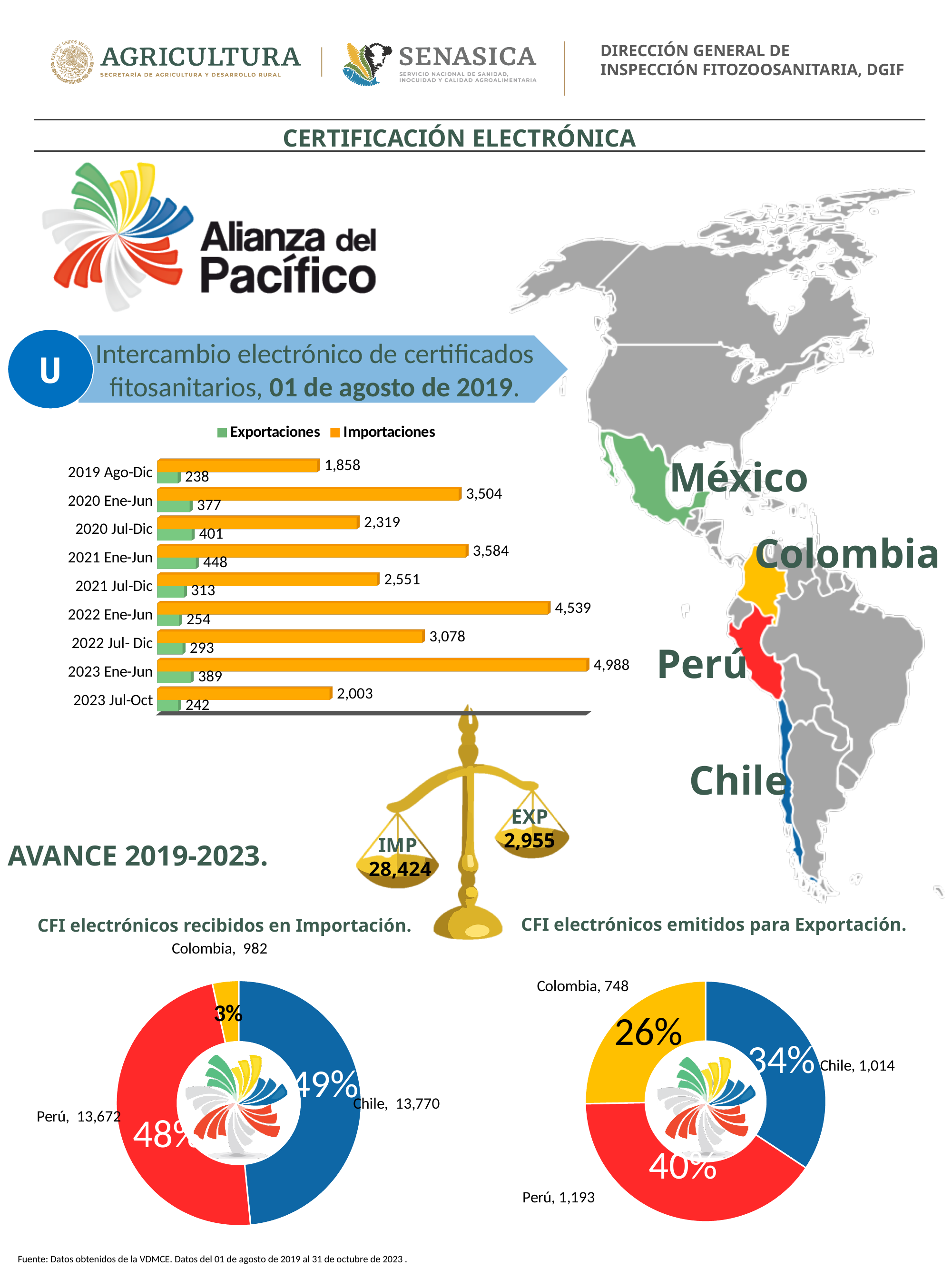
In the 'CFI electrónicos emitidos para Exportación' doughnut chart, which country has the largest share? Perú In the Exportaciones/Importaciones bar chart, which period has the highest Importaciones value? 2023 Ene-Jun In the 'CFI electrónicos recibidos en Importación' doughnut chart, what share does Colombia have? 3% In the 'CFI electrónicos emitidos para Exportación' doughnut chart, what is the value for Chile? 1,014 In the Exportaciones/Importaciones bar chart, what is the Importaciones value for 2022 Ene-Jun? 4,539 In the Exportaciones/Importaciones bar chart, what is the Exportaciones value for 2020 Jul-Dic? 401 How many periods are shown on the Exportaciones/Importaciones bar chart? 9 How many series does the legend of the Exportaciones/Importaciones bar chart list? 2 In the Exportaciones/Importaciones bar chart, what is the difference between Importaciones and Exportaciones for 2023 Ene-Jun? 4,599 In the Exportaciones/Importaciones bar chart, which period has the lowest Exportaciones value? 2019 Ago-Dic In the 'CFI electrónicos recibidos en Importación' doughnut chart, what is the value for Perú? 13,672 What kind of chart is the Exportaciones/Importaciones chart on the left of the slide? bar chart